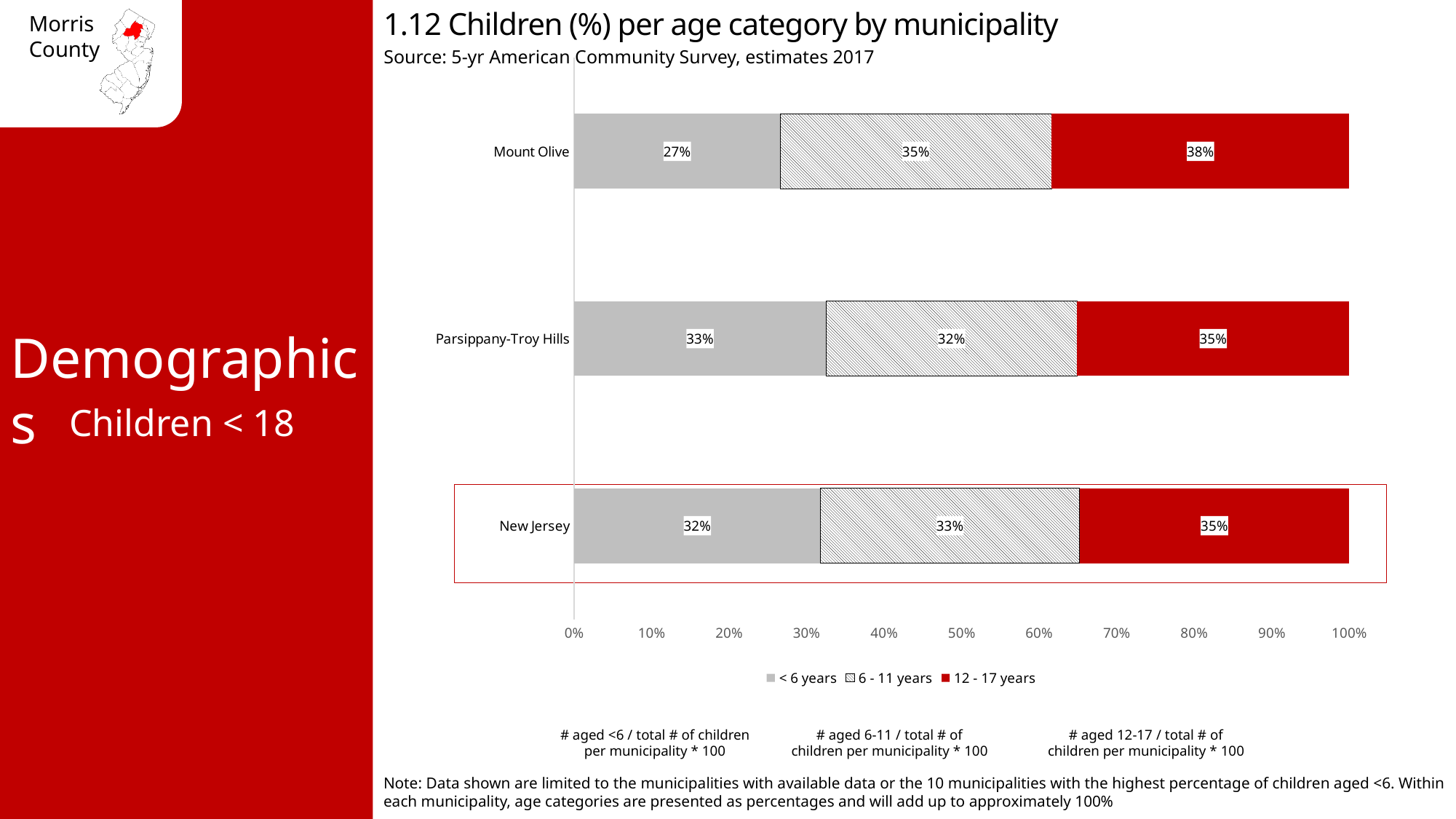
Is the < 6 years share larger for Parsippany-Troy Hills or for Mount Olive? Parsippany-Troy Hills How many series does the legend list? 3 What kind of chart is shown on the slide? Stacked bar chart Which municipality has the highest percentage of children aged 12 - 17 years? Mount Olive What is the source cited for the chart? 5-yr American Community Survey, estimates 2017 What percentage of children in New Jersey are aged 6 - 11 years? 33% Which municipality has the lowest percentage of children aged under 6 years? Mount Olive How many municipalities (categories) are shown on the chart? 3 What percentage of children in Mount Olive are aged under 6 years? 27% What is the total of the three age category percentages for Parsippany-Troy Hills? 100% What percentage of children in Parsippany-Troy Hills are aged 12 - 17 years? 35% What is the difference between the 12 - 17 years share and the < 6 years share for Mount Olive? 11%